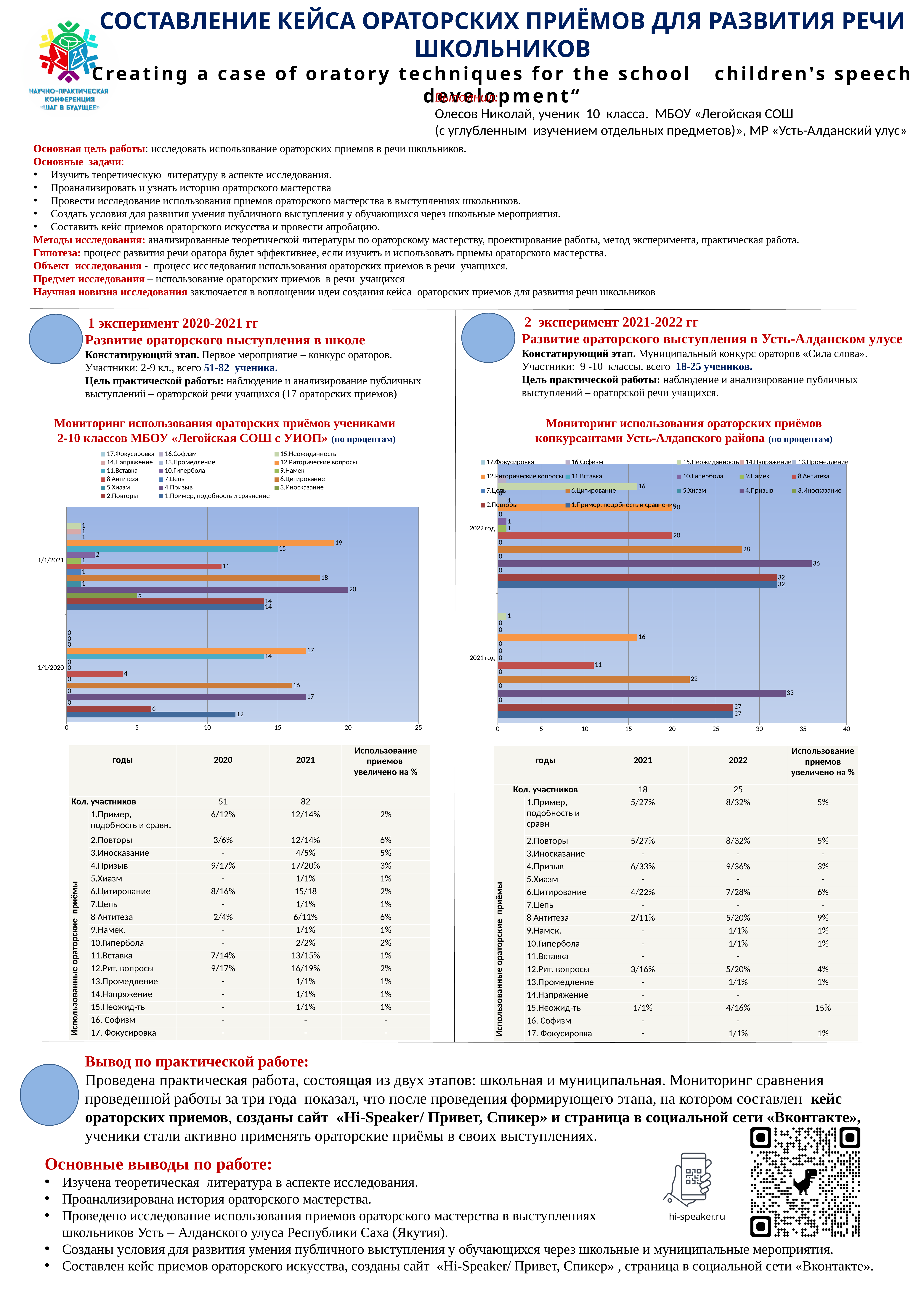
How many categories (years) are shown on the y axis of the chart titled «Мониторинг использования ораторских приёмов учениками 2-10 классов МБОУ «Легойская СОШ с УИОП»»? 2 In the chart titled «Мониторинг использования ораторских приёмов учениками 2-10 классов МБОУ «Легойская СОШ с УИОП»», what is the value of 4.Призыв for 1/1/2021? 20 What is the maximum value shown on the x axis of the chart titled «Мониторинг использования ораторских приёмов конкурсантами Усть-Алданского района»? 40 In the chart titled «Мониторинг использования ораторских приёмов учениками 2-10 классов МБОУ «Легойская СОШ с УИОП»», what is the value of 1.Пример, подобность и сравнение for 1/1/2020? 12 In the chart titled «Мониторинг использования ораторских приёмов конкурсантами Усть-Алданского района», what is the value of 6.Цитирование for 2022 год? 28 In the chart titled «Мониторинг использования ораторских приёмов учениками 2-10 классов МБОУ «Легойская СОШ с УИОП»», is the value of 12.Риторические вопросы larger for 1/1/2021 or for 1/1/2020? 1/1/2021 How many series does the legend list in the chart titled «Мониторинг использования ораторских приёмов учениками 2-10 классов МБОУ «Легойская СОШ с УИОП»»? 17 In the chart titled «Мониторинг использования ораторских приёмов конкурсантами Усть-Алданского района», what is the value of 8 Антитеза for 2021 год? 11 In the chart titled «Мониторинг использования ораторских приёмов конкурсантами Усть-Алданского района», which series has the highest value for 2021 год? 4.Призыв In the chart titled «Мониторинг использования ораторских приёмов конкурсантами Усть-Алданского района», what is the highest value shown for 2022 год? 36 In the chart titled «Мониторинг использования ораторских приёмов конкурсантами Усть-Алданского района», what is the difference between the 4.Призыв values for 2022 год and 2021 год? 3 What type of chart is the chart titled «Мониторинг использования ораторских приёмов учениками 2-10 классов МБОУ «Легойская СОШ с УИОП»»? bar chart